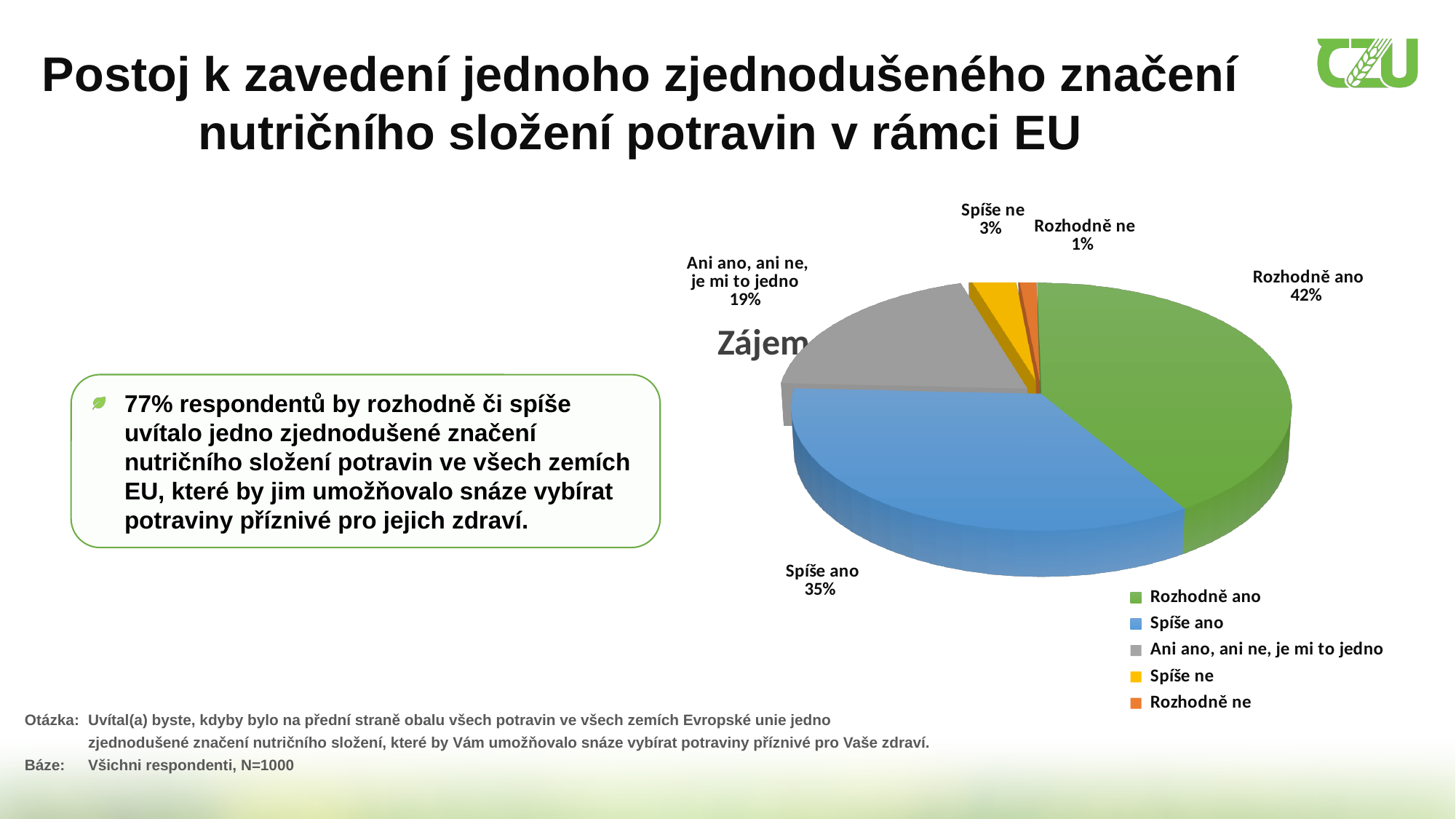
What is the difference between the values for "Rozhodně ano" and "Spíše ano"? 7% What is the value for "Rozhodně ano"? 42% What is the title of the pie chart? Zájem Which category has the smallest share of the pie? Rozhodně ne What is the value for "Spíše ne"? 3% What is the value for "Rozhodně ne"? 1% What is the value for "Ani ano, ani ne, je mi to jedno"? 19% Which is larger, the value for "Ani ano, ani ne, je mi to jedno" or the value for "Spíše ne"? Ani ano, ani ne, je mi to jedno What type of chart is shown on the slide? Pie chart What is the value for "Spíše ano"? 35% How many categories does the pie chart have? 5 Which category has the largest share of the pie? Rozhodně ano